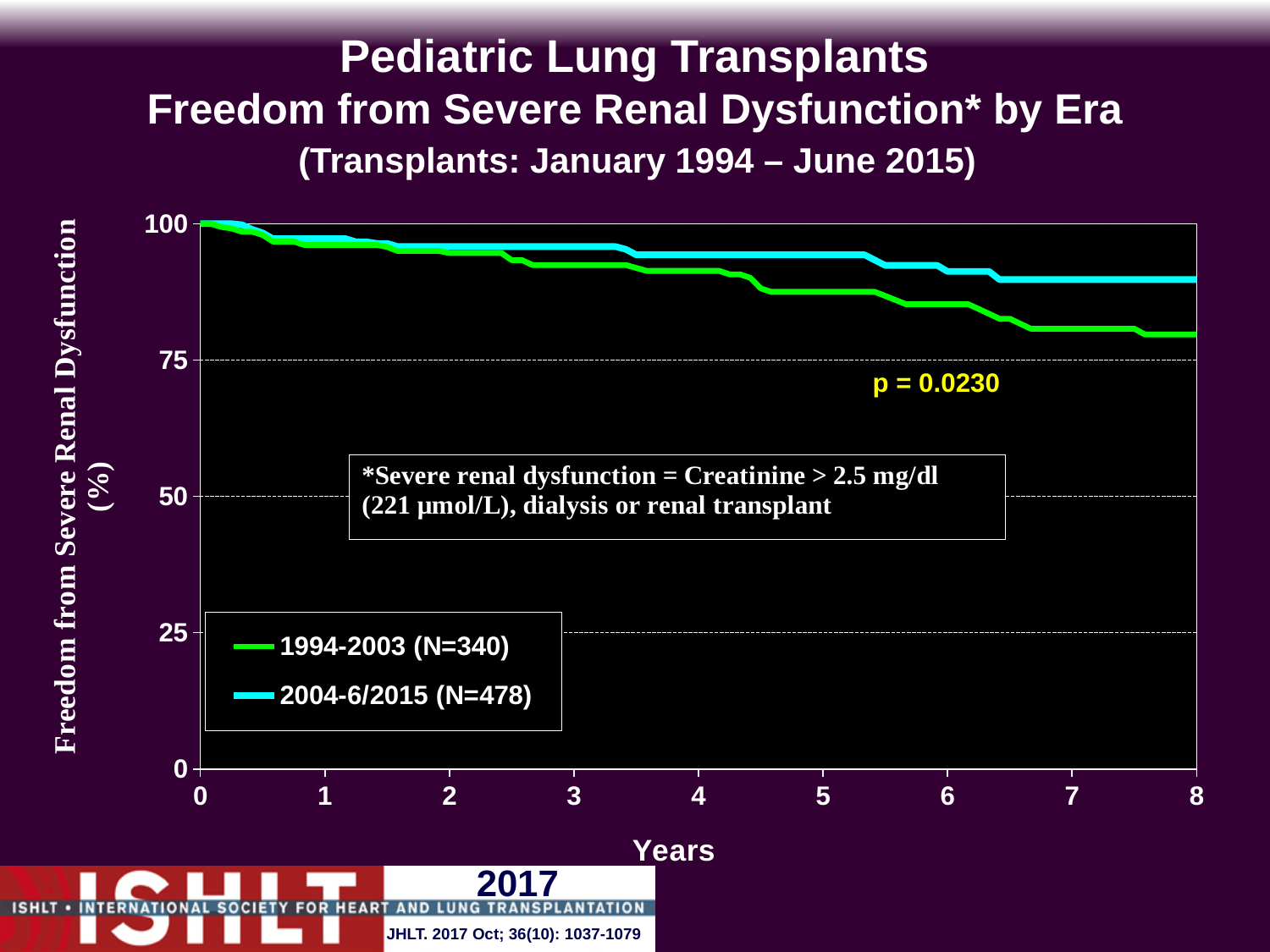
At what value do both curves start at year 0? 100 What is the label of the x axis? Years Is the value for the 1994-2003 era at 8 years greater or less than 75? greater Do the curves rise or fall as years increase? fall Which two eras are compared in the legend? 1994-2003 and 2004-6/2015 What p-value is printed on the chart? p = 0.0230 Is the value for the 2004-6/2015 era at 8 years greater or less than 75? greater What is the N for the 2004-6/2015 era shown in the legend? 478 How many series does the legend list? 2 What kind of chart is shown on the slide? line chart Which era has the higher freedom from severe renal dysfunction at 8 years? 2004-6/2015 What is the N for the 1994-2003 era shown in the legend? 340